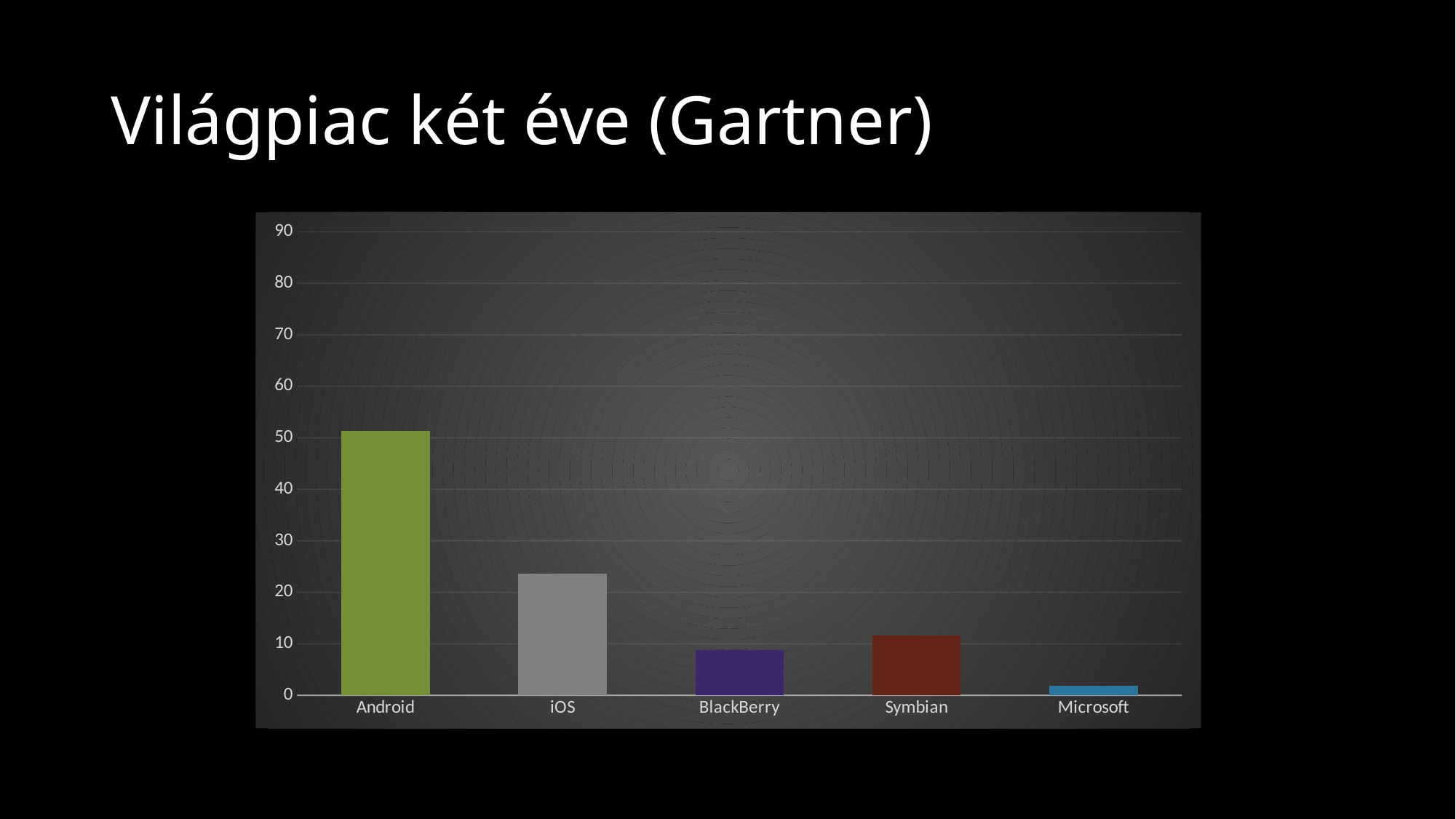
What kind of chart is shown on the slide? bar chart Which category has the highest bar in the chart? Android Is the value for Microsoft greater or less than 10? less How many categories are shown on the x axis of the chart? 5 Is the value for Android greater or less than 50? greater Is the value for Symbian greater or less than 10? greater Which category has the lowest bar in the chart? Microsoft Which is larger, the value for Symbian or the value for BlackBerry? Symbian Which is larger, the value for iOS or the value for Symbian? iOS What is the title of the slide? Világpiac két éve (Gartner)